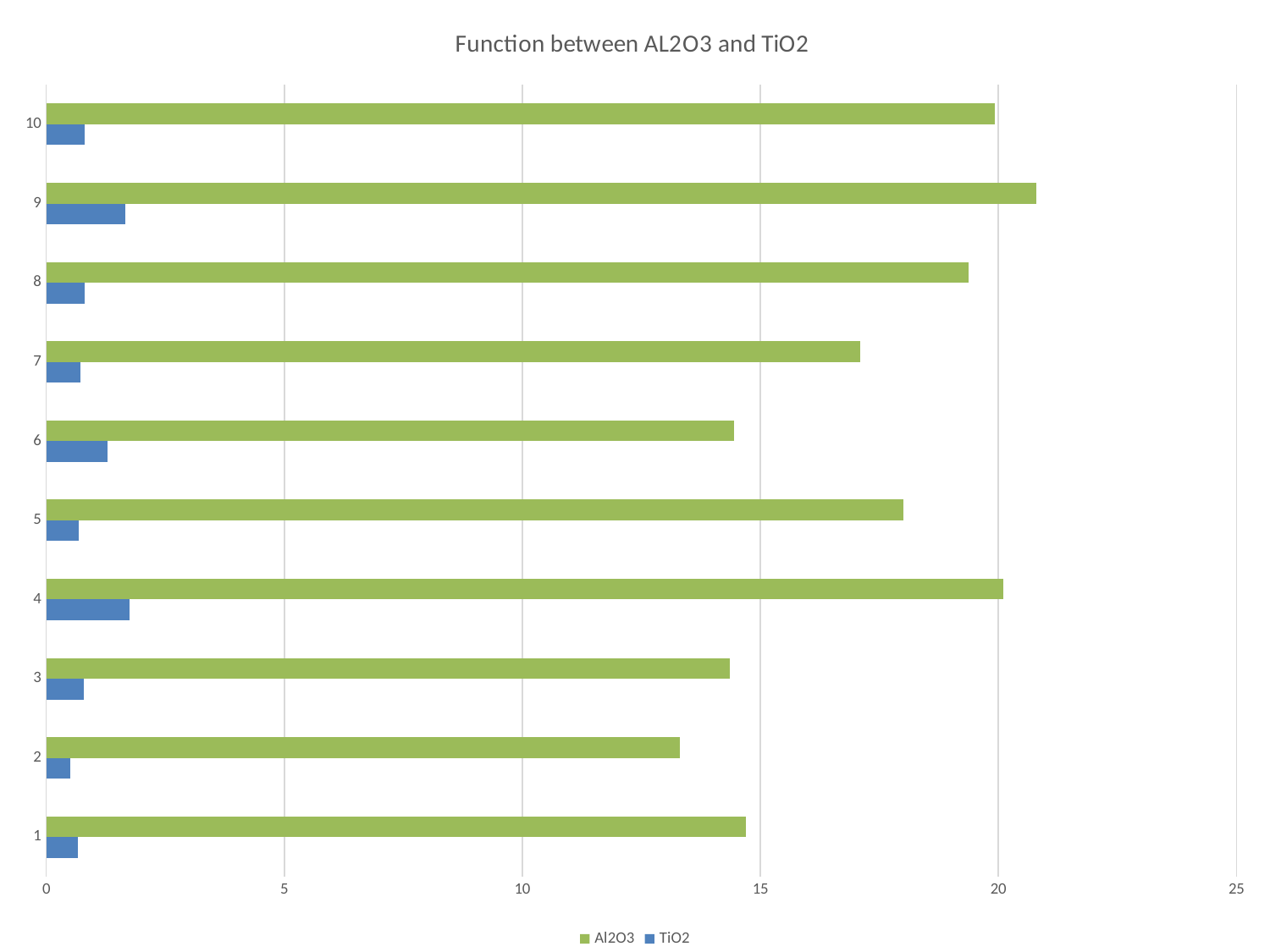
Which is larger, the TiO2 value for category 4 or for category 6? category 4 What is the title of the chart? Function between AL2O3 and TiO2 How many series does the legend list? 2 Is the Al2O3 value for category 2 greater or less than 15? less Is the Al2O3 value for category 7 greater or less than 15? greater What type of chart is shown on the slide? bar chart Which category has the highest Al2O3 value? 9 Which category has the lowest Al2O3 value? 2 Which is larger, the Al2O3 value for category 5 or for category 7? category 5 How many categories are shown on the vertical axis? 10 Is the TiO2 value for category 4 greater or less than 5? less